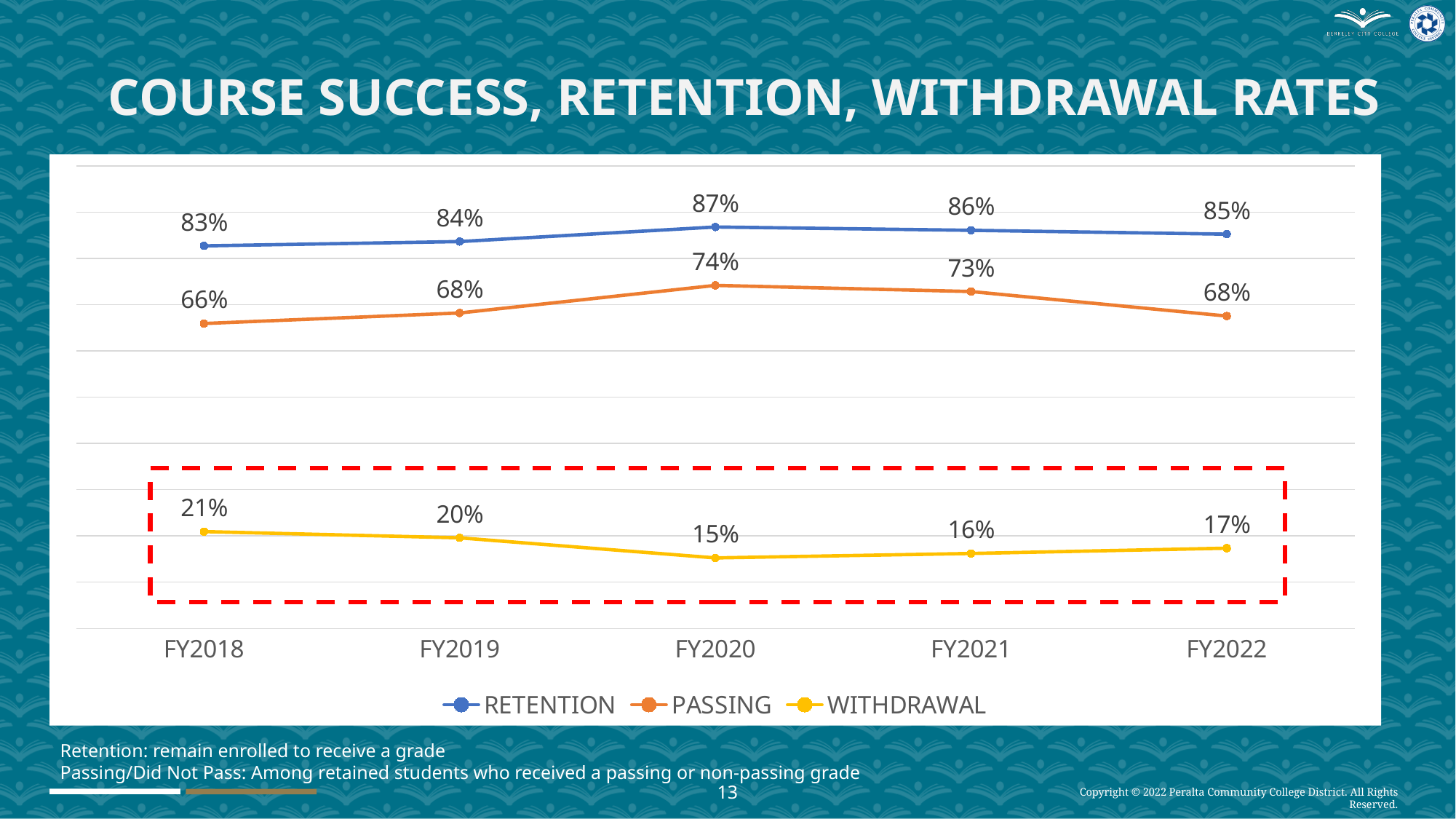
Does the withdrawal rate rise or fall from FY2018 to FY2020? Fall How many fiscal years are shown on the x axis? 5 In which fiscal year is the passing rate highest? FY2020 What is the passing rate for FY2018? 66% Which is larger, the withdrawal rate in FY2018 or in FY2021? FY2018 What is the difference between the retention rate and the passing rate in FY2022? 17% What is the retention rate for FY2020? 87% In which fiscal year is the withdrawal rate lowest? FY2020 Which series is drawn in yellow? WITHDRAWAL What kind of chart is shown on the slide? Line chart What is the withdrawal rate for FY2022? 17% How many series does the legend list? 3